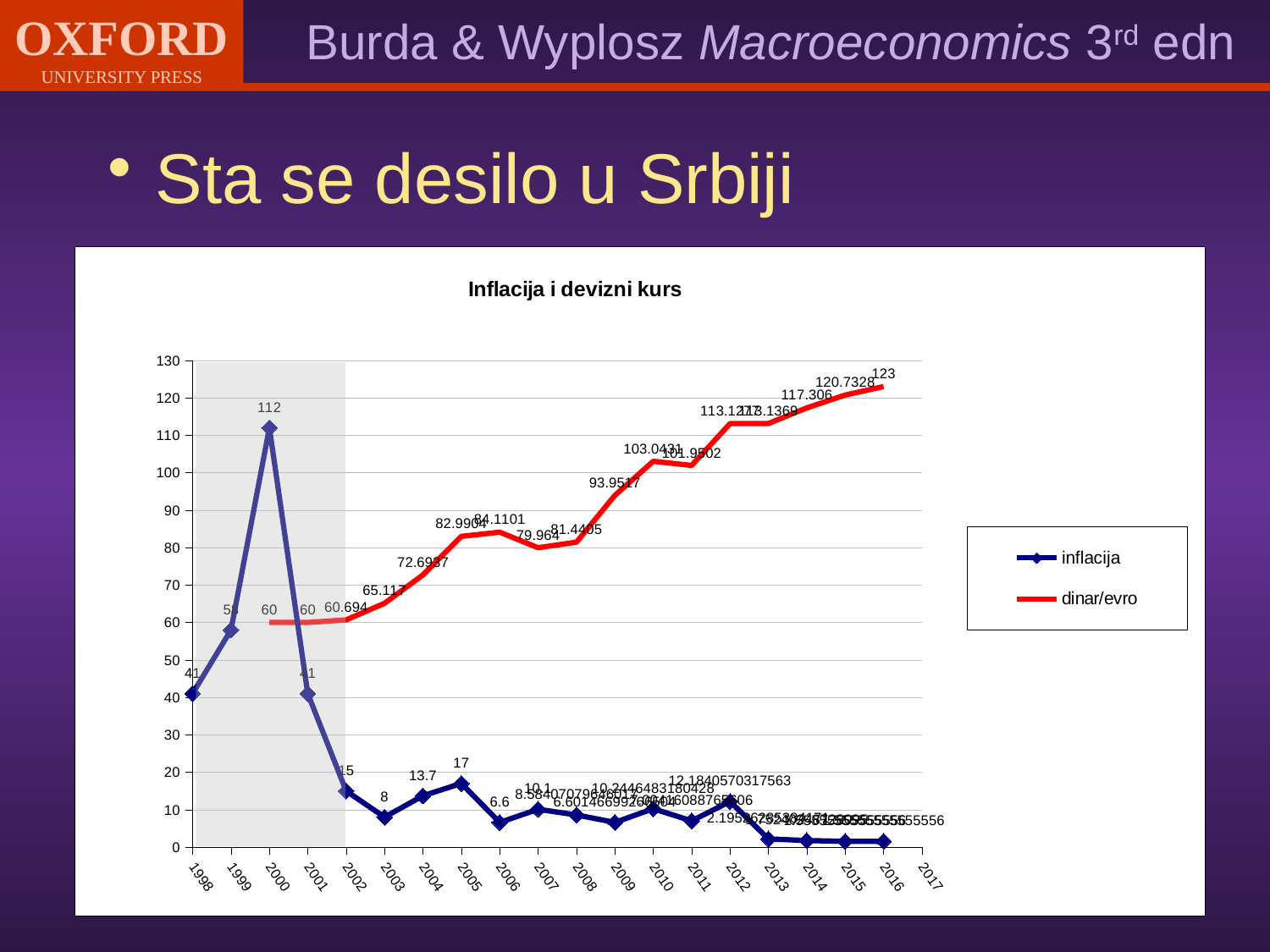
What kind of chart is shown on the slide? line chart What is the difference between the inflacija values for 2000 and 2001? 71 What is the dinar/evro value for 2016? 123 In which year is the inflacija series at its highest? 2000 Which is larger, the inflacija value for 2005 or for 2006? 2005 How many series does the legend list? 2 What is the title of the chart? Inflacija i devizni kurs In which year is the dinar/evro series at its highest? 2016 What is the inflacija value for 2003? 8 What is the inflacija value for 2000? 112 What is the inflacija value for 2005? 17 Is the dinar/evro value for 2010 greater or less than 100? greater